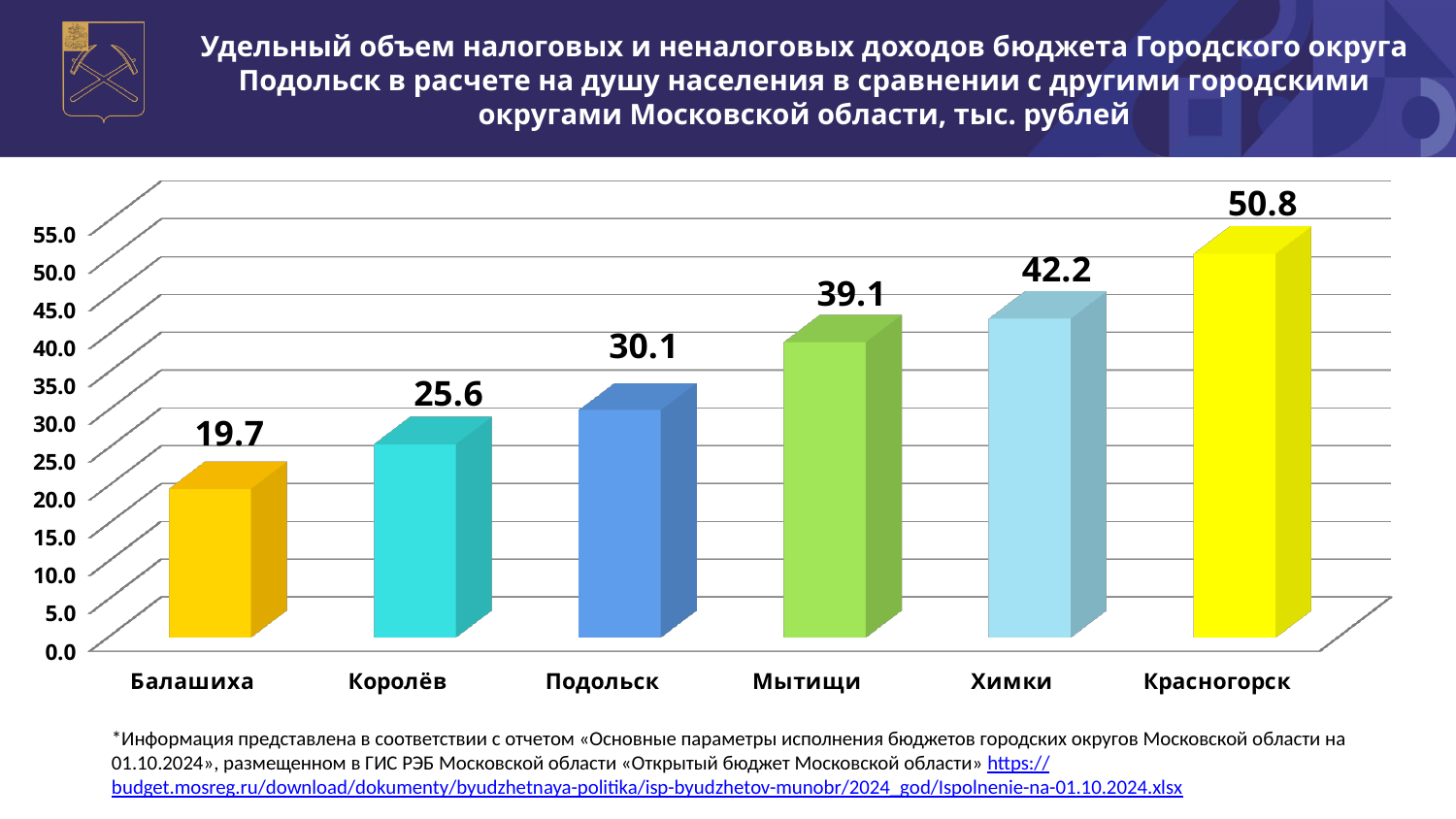
What is the value for Химки? 42.2 What kind of chart is shown on the slide? bar chart How many cities are shown on the chart? 6 What is the difference between the values for Мытищи and Королёв? 13.5 Which city has the lowest value? Балашиха Which is larger, the value for Мытищи or the value for Химки? Химки What is the value for Подольск? 30.1 What is the difference between the values for Красногорск and Подольск? 20.7 Which city has the highest value? Красногорск Do the values rise or fall from left to right along the x axis? rise What is the value for Балашиха? 19.7 Is the value for Королёв greater or less than 30.0? less